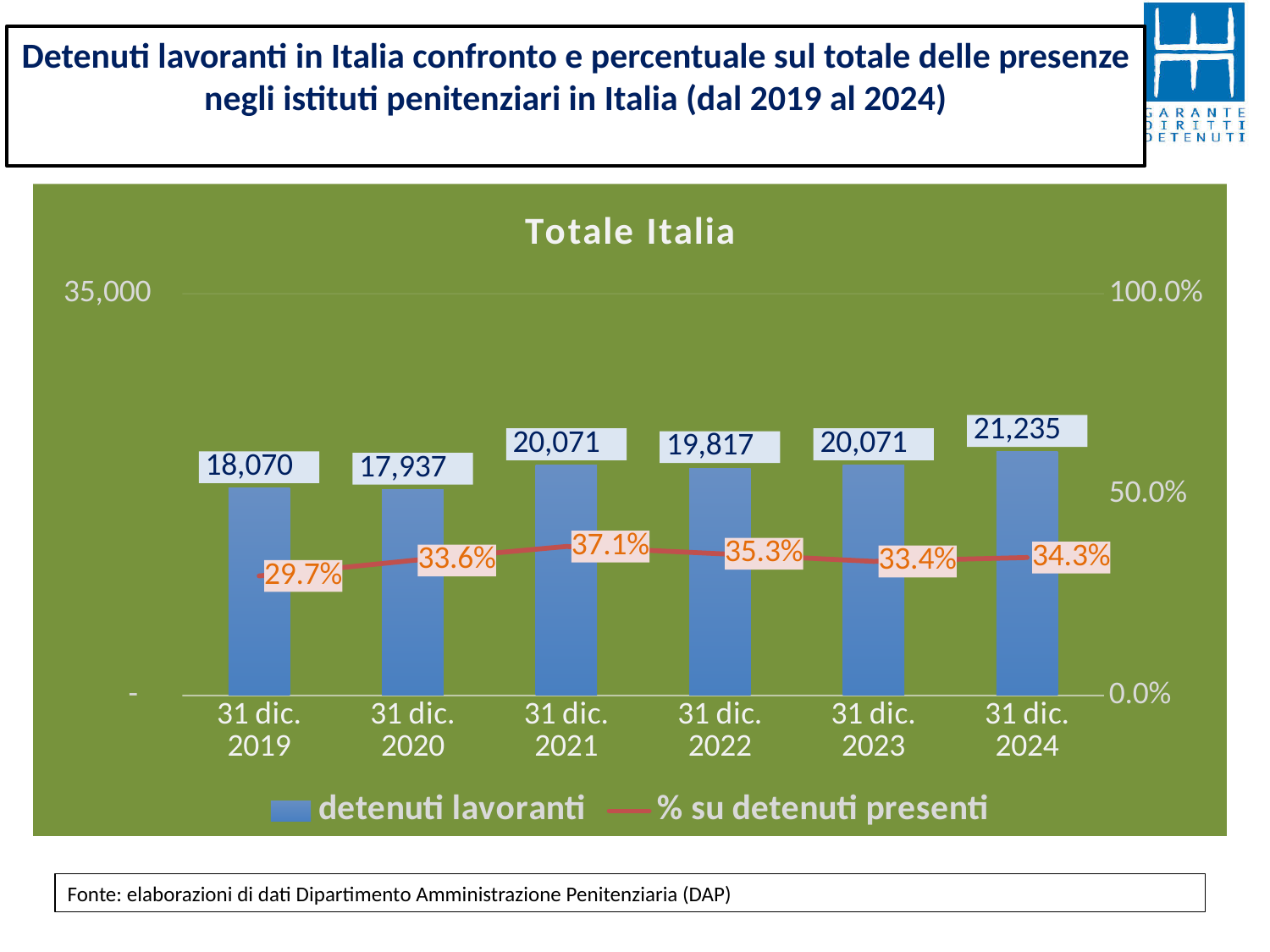
How many series does the legend list? 2 What is the title of the chart? Totale Italia How many dates are shown on the x axis of the chart? 6 What is the value of 'detenuti lavoranti' at 31 dic. 2019? 18,070 Which date has the lowest number of 'detenuti lavoranti'? 31 dic. 2020 What is the '% su detenuti presenti' value at 31 dic. 2019? 29.7% What is the value of 'detenuti lavoranti' at 31 dic. 2024? 21,235 What is the '% su detenuti presenti' value at 31 dic. 2021? 37.1% Which is larger, the 'detenuti lavoranti' value at 31 dic. 2022 or at 31 dic. 2023? 31 dic. 2023 Which date has the lowest '% su detenuti presenti' value? 31 dic. 2019 Which date has the highest number of 'detenuti lavoranti'? 31 dic. 2024 What is the difference in 'detenuti lavoranti' between 31 dic. 2024 and 31 dic. 2019? 3,165